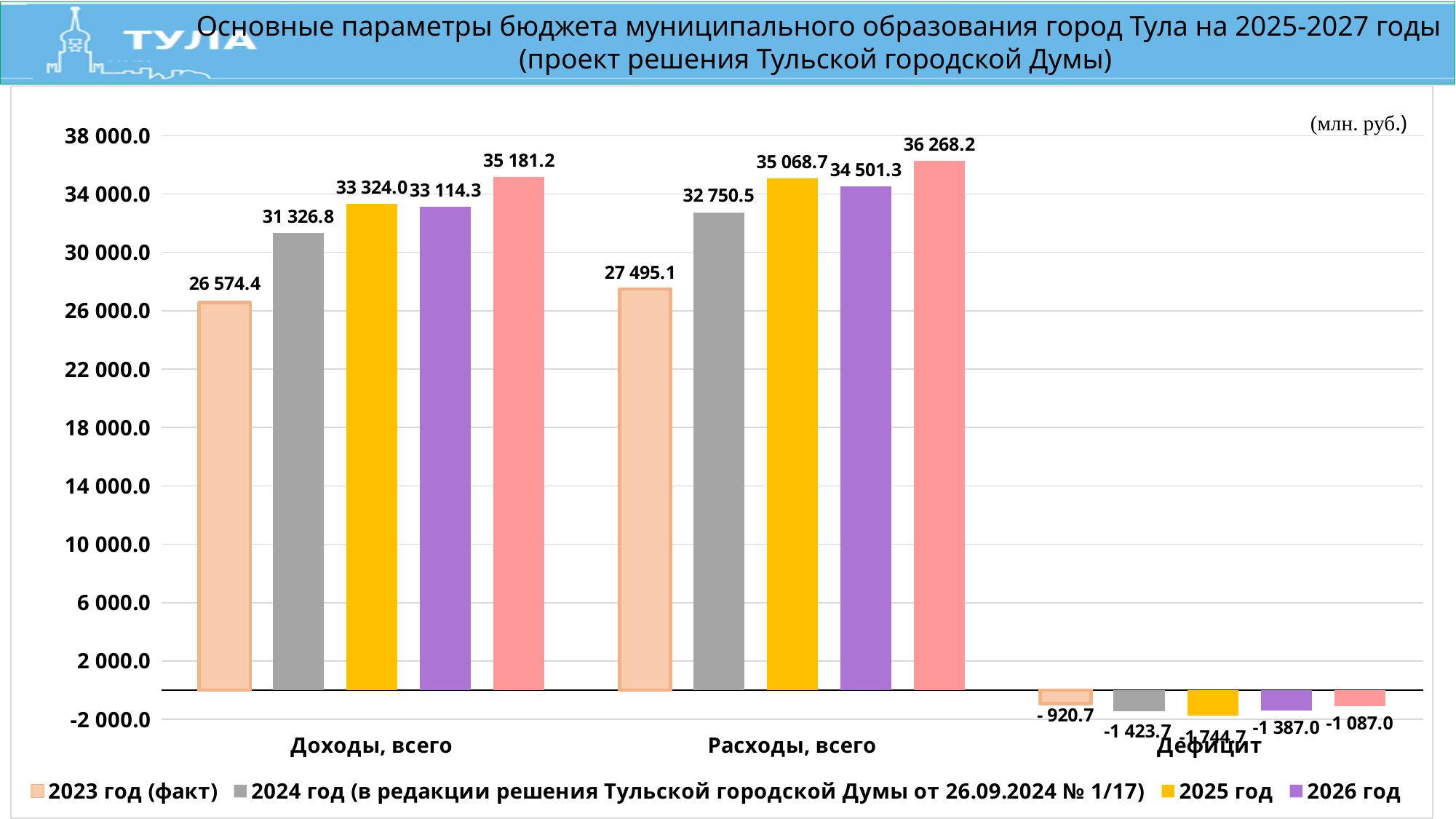
Which year has the most negative value in the category Дефицит? 2025 год What is the highest value among the bars in the category Доходы, всего? 35 181.2 What unit of measurement is indicated in the top right corner of the chart? млн. руб. What is the difference between Расходы, всего and Доходы, всего for 2025 год? 1 744.7 How many categories are shown on the x axis? 3 Which is larger: Доходы, всего for 2024 год or Доходы, всего for 2026 год? 2026 год What is the value for 2023 год (факт) in the category Доходы, всего? 26 574.4 Is the value for 2024 год in Расходы, всего greater or less than 30 000.0? greater How many series does the legend list? 4 What is the value for 2025 год in the category Расходы, всего? 35 068.7 What is the value for 2026 год in the category Дефицит? -1 387.0 What type of chart is shown on the slide? bar chart